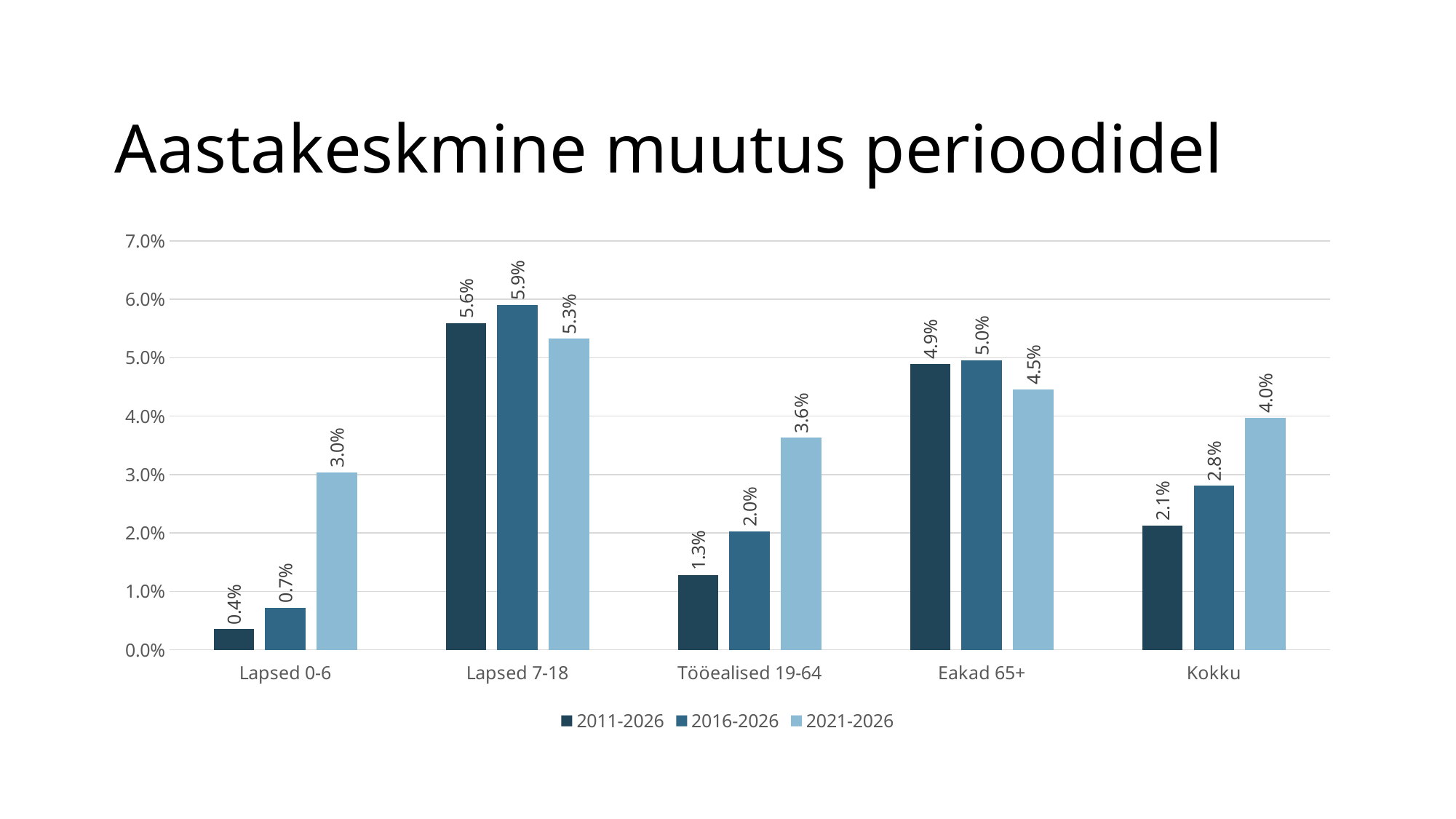
What kind of chart is shown on the slide? Bar chart Which is larger for Eakad 65+: the 2011-2026 value or the 2021-2026 value? 2011-2026 Which category has the lowest value in the 2011-2026 series? Lapsed 0-6 What is the title of the chart? Aastakeskmine muutus perioodidel Which category has the highest value in the 2016-2026 series? Lapsed 7-18 What is the value for Tööealised 19-64 in the 2011-2026 series? 1.3% What is the value for Lapsed 0-6 in the 2021-2026 series? 3.0% What is the value for Kokku in the 2016-2026 series? 2.8% Is the value for Kokku in the 2021-2026 series greater or less than 3.0%? greater How many series does the legend list? 3 How many categories are shown on the x axis? 5 What is the difference between the 2021-2026 and 2011-2026 values for Tööealised 19-64? 2.3%